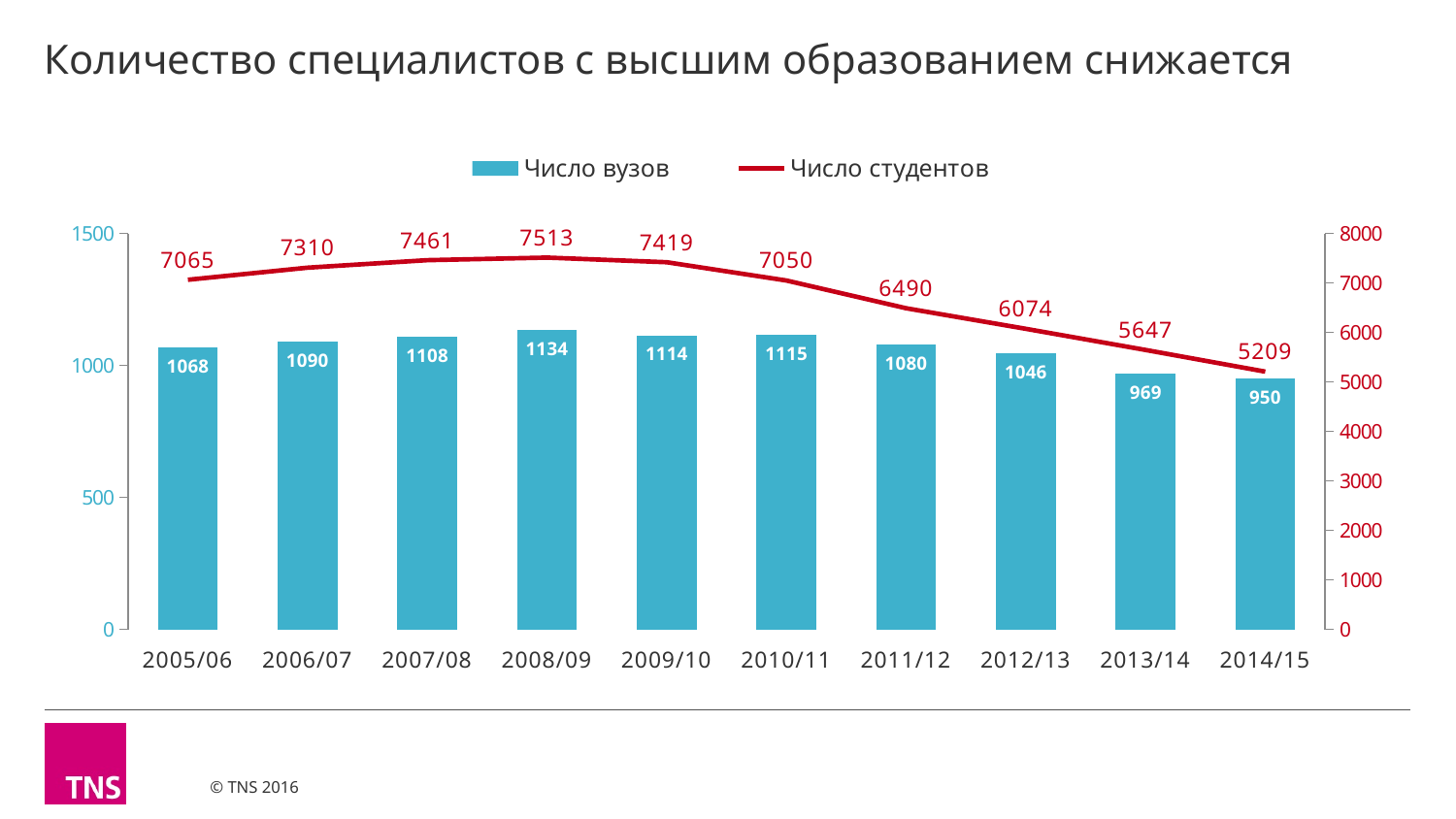
Which is larger, Число вузов in 2006/07 or in 2012/13? 2006/07 Does Число студентов rise or fall from 2008/09 to 2014/15? Fall Which year has the highest value for Число студентов? 2008/09 What is the value of Число вузов for 2008/09? 1134 How many years are shown on the x axis? 10 What is the title of the slide? Количество специалистов с высшим образованием снижается What kind of chart is shown on the slide? Combined bar and line chart What is the value of Число студентов for 2005/06? 7065 How many series does the legend list? 2 What is the difference between Число студентов in 2008/09 and 2014/15? 2304 What is the value of Число студентов for 2014/15? 5209 Which year has the lowest value for Число вузов? 2014/15